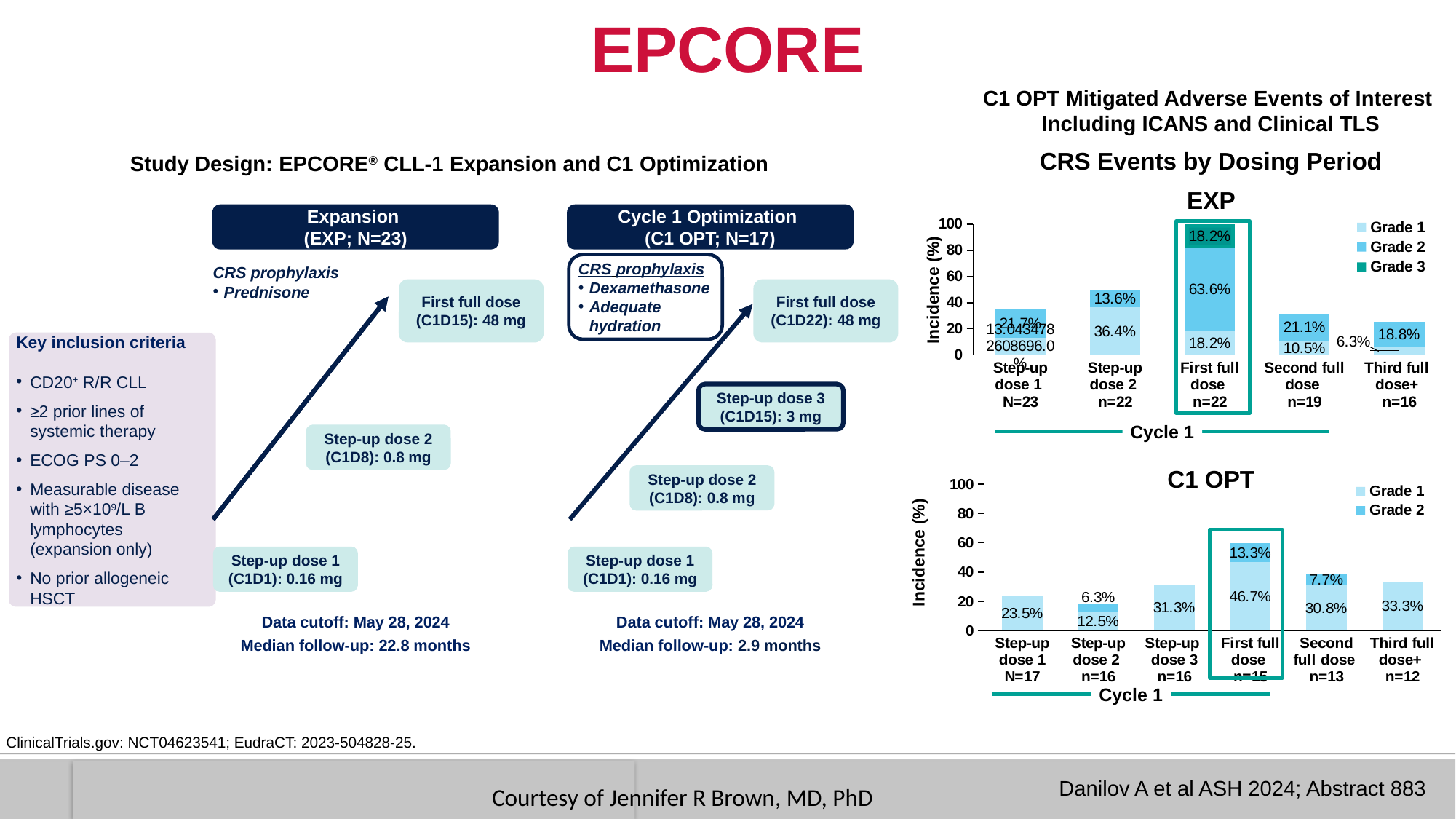
In the EXP chart, what is the Grade 2 CRS incidence at the First full dose? 63.6% In the EXP chart, what is the Grade 1 CRS incidence at Step-up dose 2? 36.4% What type of chart is the C1 OPT chart? Stacked bar chart In the EXP chart, what is the total CRS incidence (all grades) at the First full dose? 100% In the C1 OPT chart, what is the Grade 1 CRS incidence at the First full dose? 46.7% How many dosing periods are shown on the x axis of the C1 OPT chart? 6 In the C1 OPT chart, which has the higher Grade 1 incidence: Step-up dose 1 or Step-up dose 3? Step-up dose 3 How many grades does the legend of the EXP chart list? 3 How many grades does the legend of the C1 OPT chart list? 2 In the EXP chart, what is the Grade 3 CRS incidence at the First full dose? 18.2% In the C1 OPT chart, what is the total CRS incidence at the First full dose? 60% In the C1 OPT chart, which dosing period has the highest total CRS incidence? First full dose